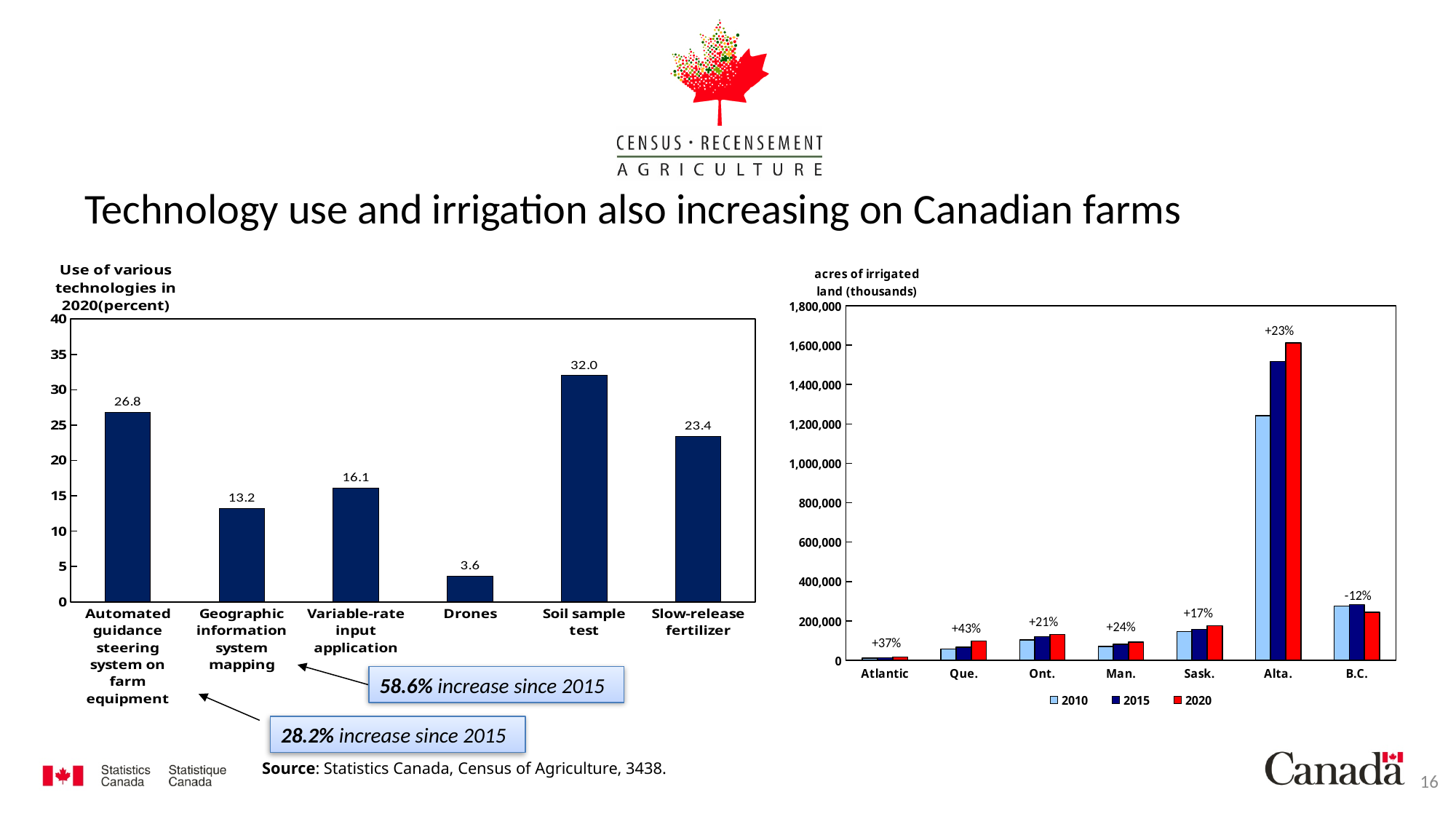
In the left chart on technology use in 2020, what is the value for Drones? 3.6 How many technology categories are shown in the left chart? 6 In the right chart on acres of irrigated land, how many series does the legend list? 3 In the right chart on acres of irrigated land, is the 2020 value for Alta. greater or less than 1,400,000? greater What kind of chart is the right chart on acres of irrigated land? Bar chart In the left chart on technology use in 2020, which technology has the lowest value? Drones In the right chart on acres of irrigated land, which province has the highest values? Alta. In the left chart on technology use in 2020, what is the difference between Automated guidance steering system on farm equipment and Geographic information system mapping? 13.6 In the left chart on technology use in 2020, what is the value for Soil sample test? 32.0 In the right chart on acres of irrigated land, what percentage change is labelled above B.C.? -12% In the left chart on technology use in 2020, which technology has the highest value? Soil sample test In the left chart on technology use in 2020, which is larger: Variable-rate input application or Slow-release fertilizer? Slow-release fertilizer